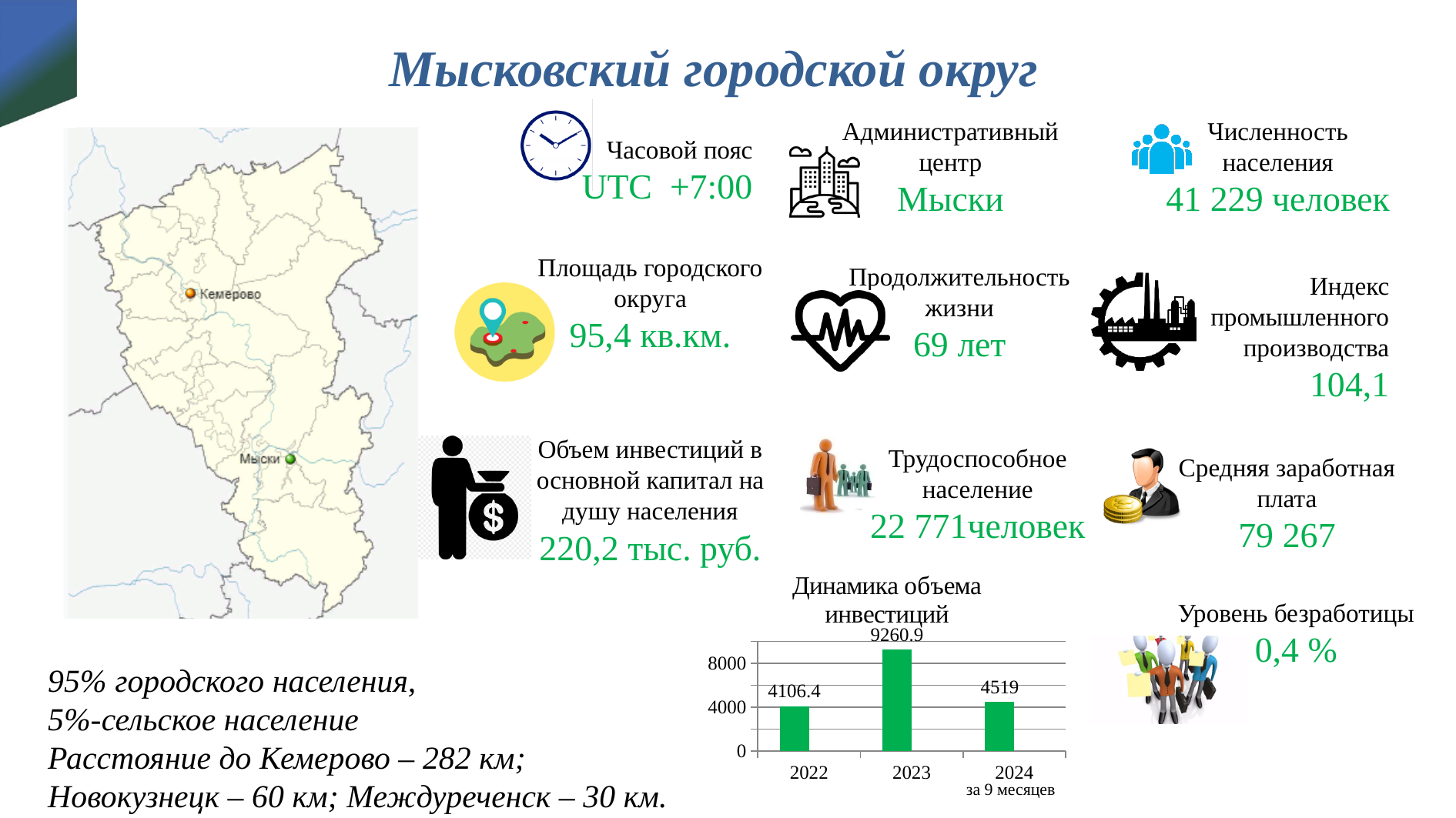
Which year has the lowest value in the 'Динамика объема инвестиций' chart? 2022 What is the value for 2023 in the 'Динамика объема инвестиций' chart? 9260.9 What kind of chart is 'Динамика объема инвестиций'? bar chart In the 'Динамика объема инвестиций' chart, which is larger: the value for 2023 or the value for 2024? 2023 Is the value for 2023 in the 'Динамика объема инвестиций' chart greater or less than 8000? greater How many years are shown in the 'Динамика объема инвестиций' chart? 3 What is the value for 2024 in the 'Динамика объема инвестиций' chart? 4519 Which year has the highest value in the 'Динамика объема инвестиций' chart? 2023 What is the difference between the 2024 and 2022 values in the 'Динамика объема инвестиций' chart? 412.6 What is the value for 2022 in the 'Динамика объема инвестиций' chart? 4106.4 What is the difference between the 2023 and 2022 values in the 'Динамика объема инвестиций' chart? 5154.5 What note is printed under the 2024 label in the 'Динамика объема инвестиций' chart? за 9 месяцев